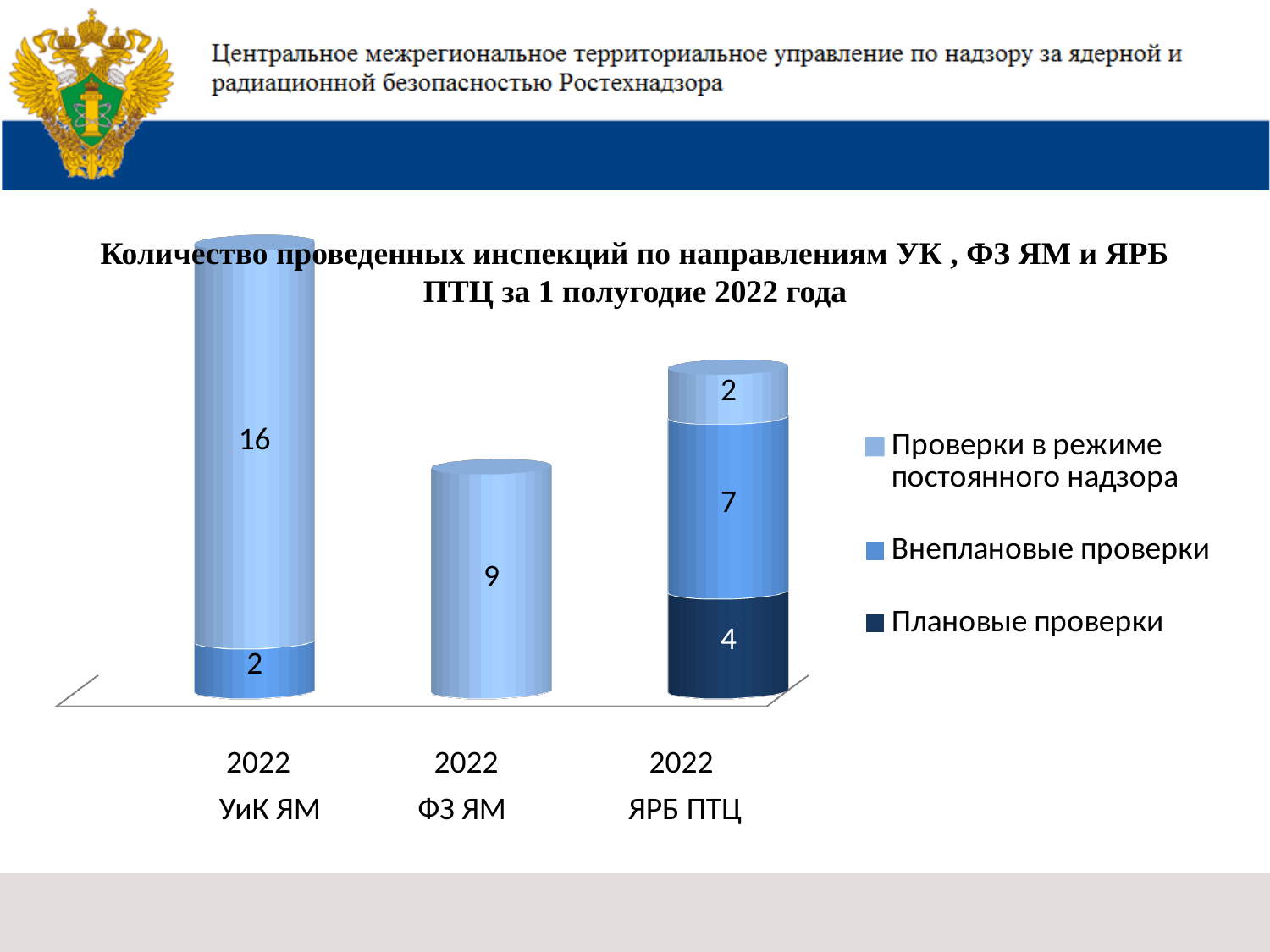
What is the total of the stacked bar for ЯРБ ПТЦ? 13 Which category has the highest value for 'Проверки в режиме постоянного надзора'? УиК ЯМ What is the value of 'Плановые проверки' for ЯРБ ПТЦ? 4 What is the value of 'Проверки в режиме постоянного надзора' for УиК ЯМ? 16 What is the total of the stacked bar for УиК ЯМ? 18 What type of chart is shown on the slide? Bar chart (stacked) What is the value of 'Внеплановые проверки' for ЯРБ ПТЦ? 7 How many categories are shown on the x axis? 3 What is the value of 'Проверки в режиме постоянного надзора' for ФЗ ЯМ? 9 What is the difference between 'Проверки в режиме постоянного надзора' for УиК ЯМ and for ФЗ ЯМ? 7 Which is larger: 'Внеплановые проверки' for ЯРБ ПТЦ or 'Внеплановые проверки' for УиК ЯМ? ЯРБ ПТЦ How many series does the legend list? 3